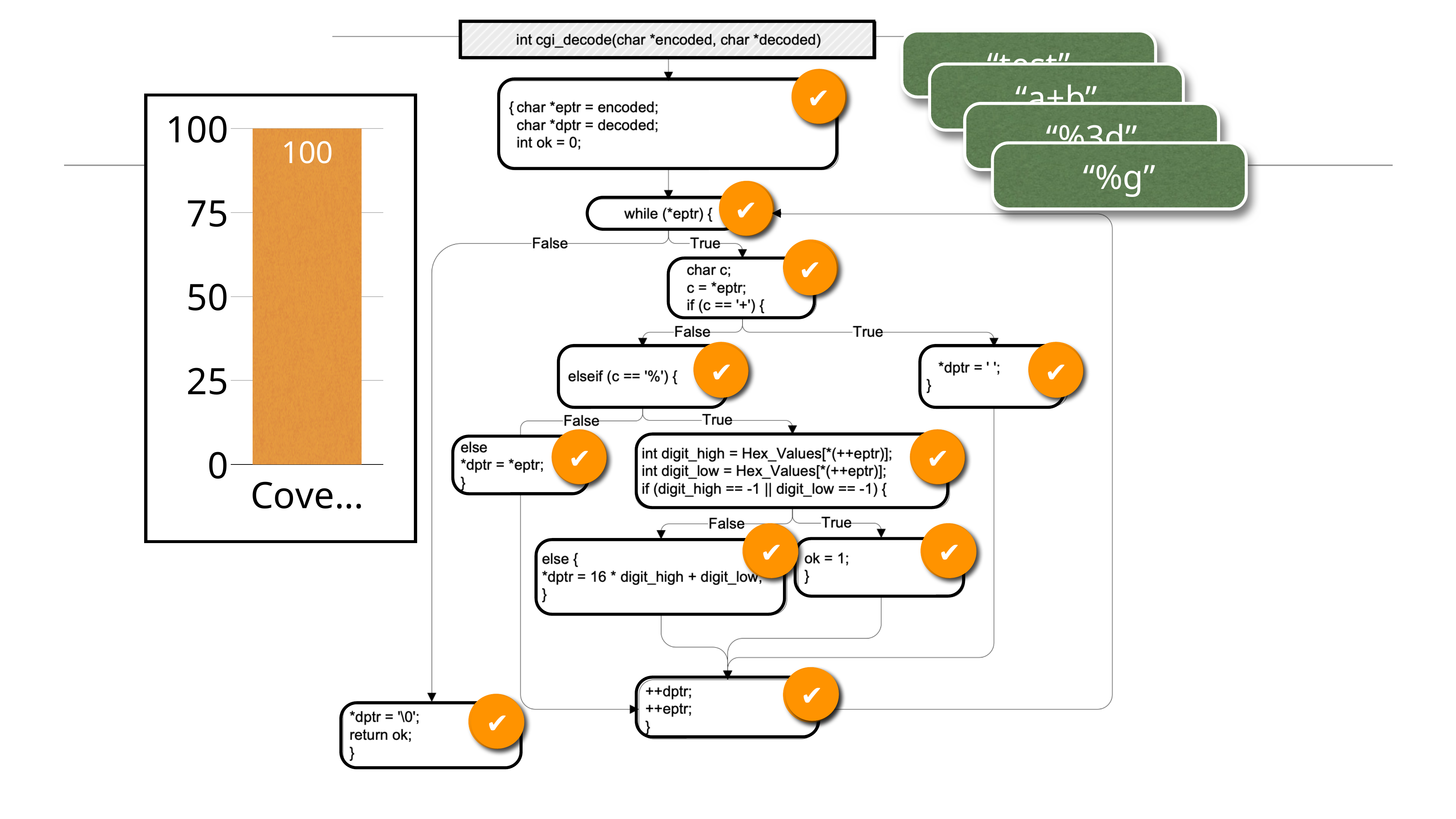
Is the value of the bar in the chart on the left greater or less than 50? greater What is the lowest tick value shown on the vertical axis of the chart on the left? 0 What is the highest tick value shown on the vertical axis of the chart on the left? 100 Is the value of the bar in the chart on the left greater or less than 75? greater What value is shown on the bar in the bar chart on the left of the slide? 100 How many bars does the chart on the left of the slide show? 1 What kind of chart is shown on the left of the slide? bar chart